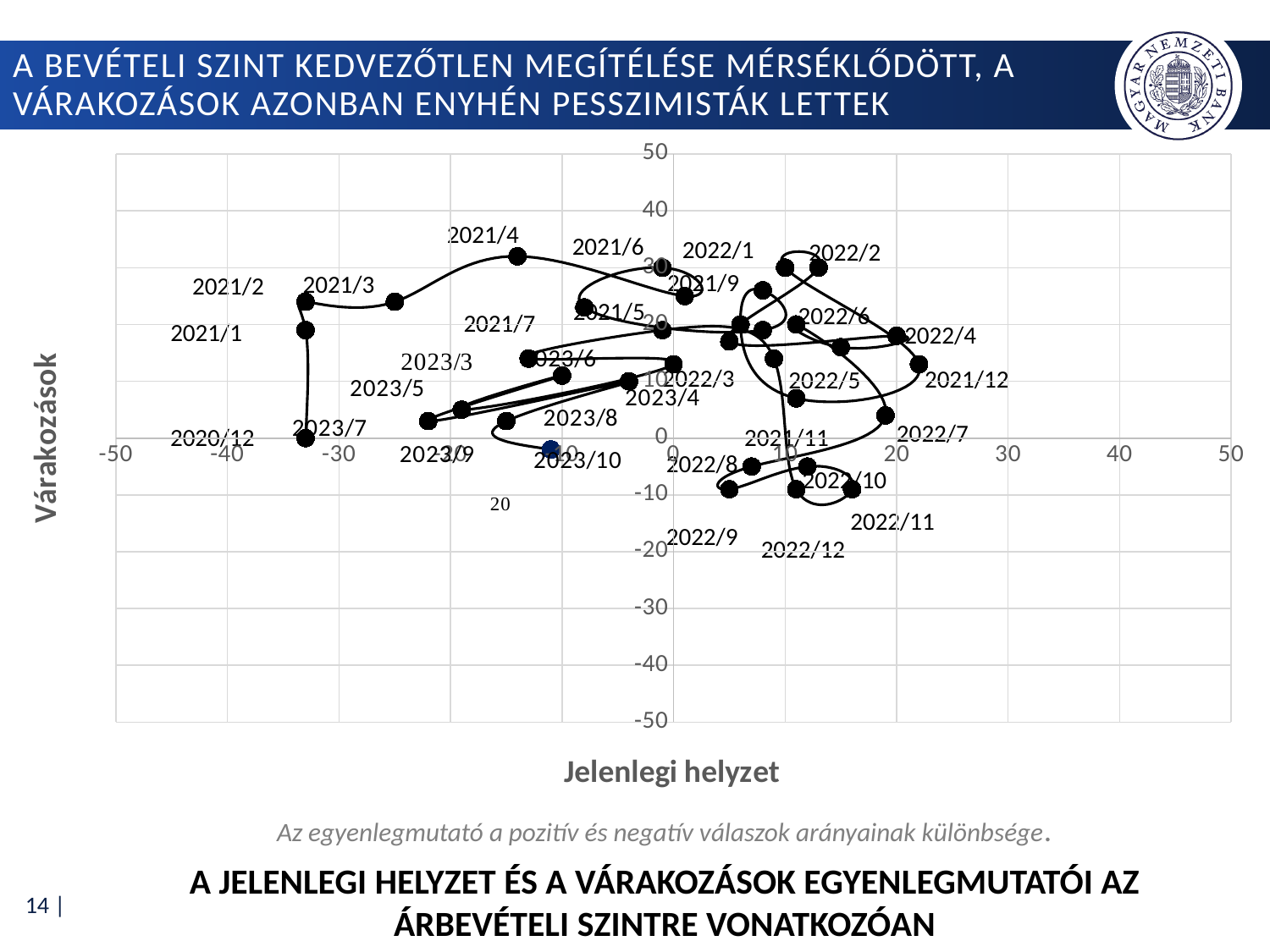
What is the title of the horizontal axis of the chart? Jelenlegi helyzet Which point has the higher Jelenlegi helyzet value, 2022/4 or 2021/1? 2022/4 What is the title of the vertical axis of the chart? Várakozások Is the Várakozások value for 2022/2 greater or less than 20? greater What kind of chart is shown on the slide? scatter chart Is the Várakozások value for 2022/9 greater or less than 0? less Is the Jelenlegi helyzet value for 2021/2 greater or less than -20? less Which point has the higher Várakozások value, 2021/4 or 2023/10? 2021/4